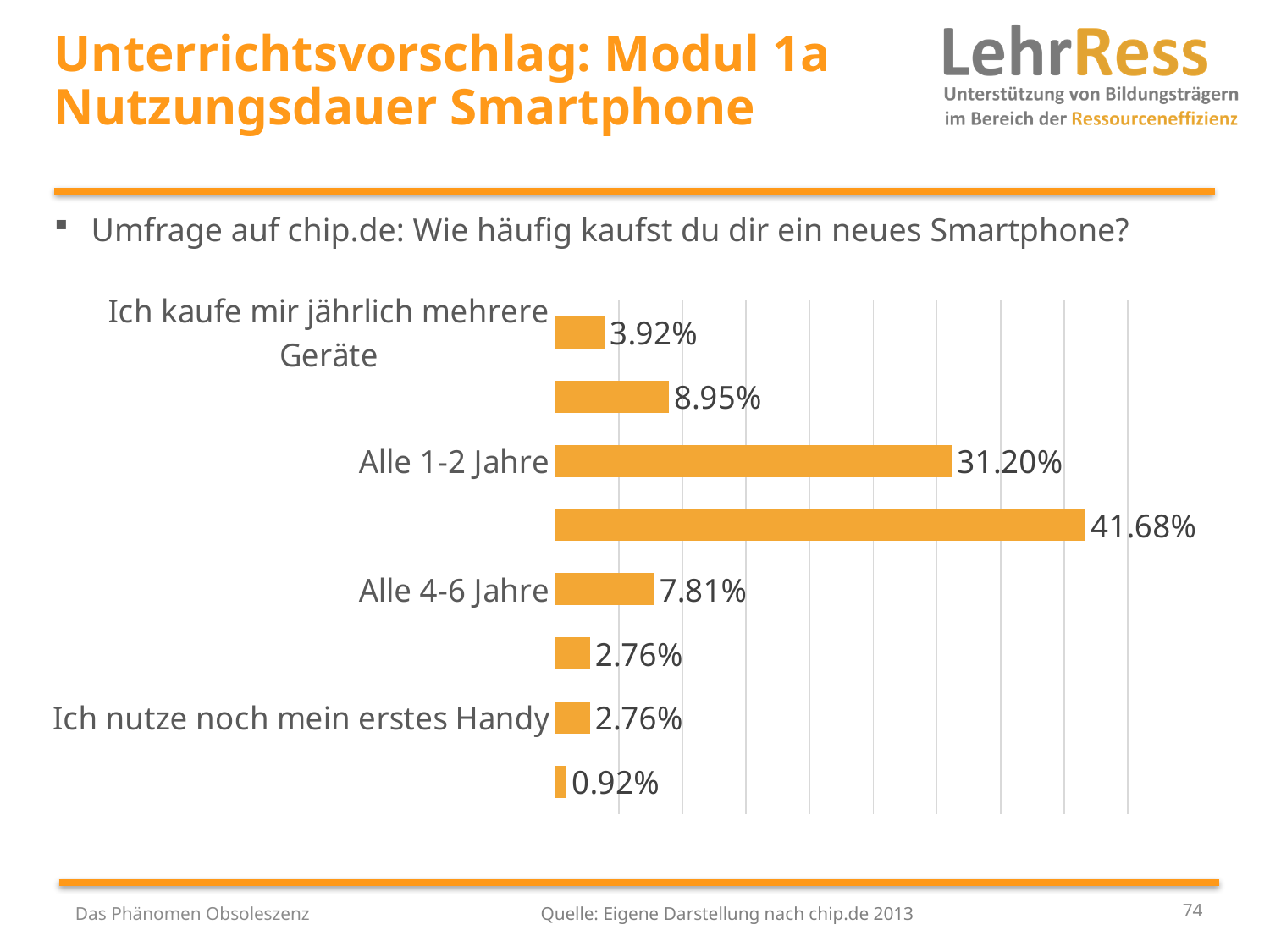
What is the value for "Ich nutze noch mein erstes Handy"? 2.76% Which has the larger value, "Alle 1-2 Jahre" or "Alle 4-6 Jahre"? Alle 1-2 Jahre What kind of chart is shown on the slide? Bar chart How many bars are plotted in the chart? 8 What is the difference between the values for "Alle 1-2 Jahre" and "Alle 4-6 Jahre"? 23.39% What is the difference between the values for "Alle 4-6 Jahre" and "Ich nutze noch mein erstes Handy"? 5.05% What is the highest value shown in the chart? 41.68% What is the value for "Alle 4-6 Jahre"? 7.81% What is the lowest value shown in the chart? 0.92% What is the value for "Alle 1-2 Jahre"? 31.20% What survey question does the chart present, according to the slide? Wie häufig kaufst du dir ein neues Smartphone? What is the value for "Ich kaufe mir jährlich mehrere Geräte"? 3.92%